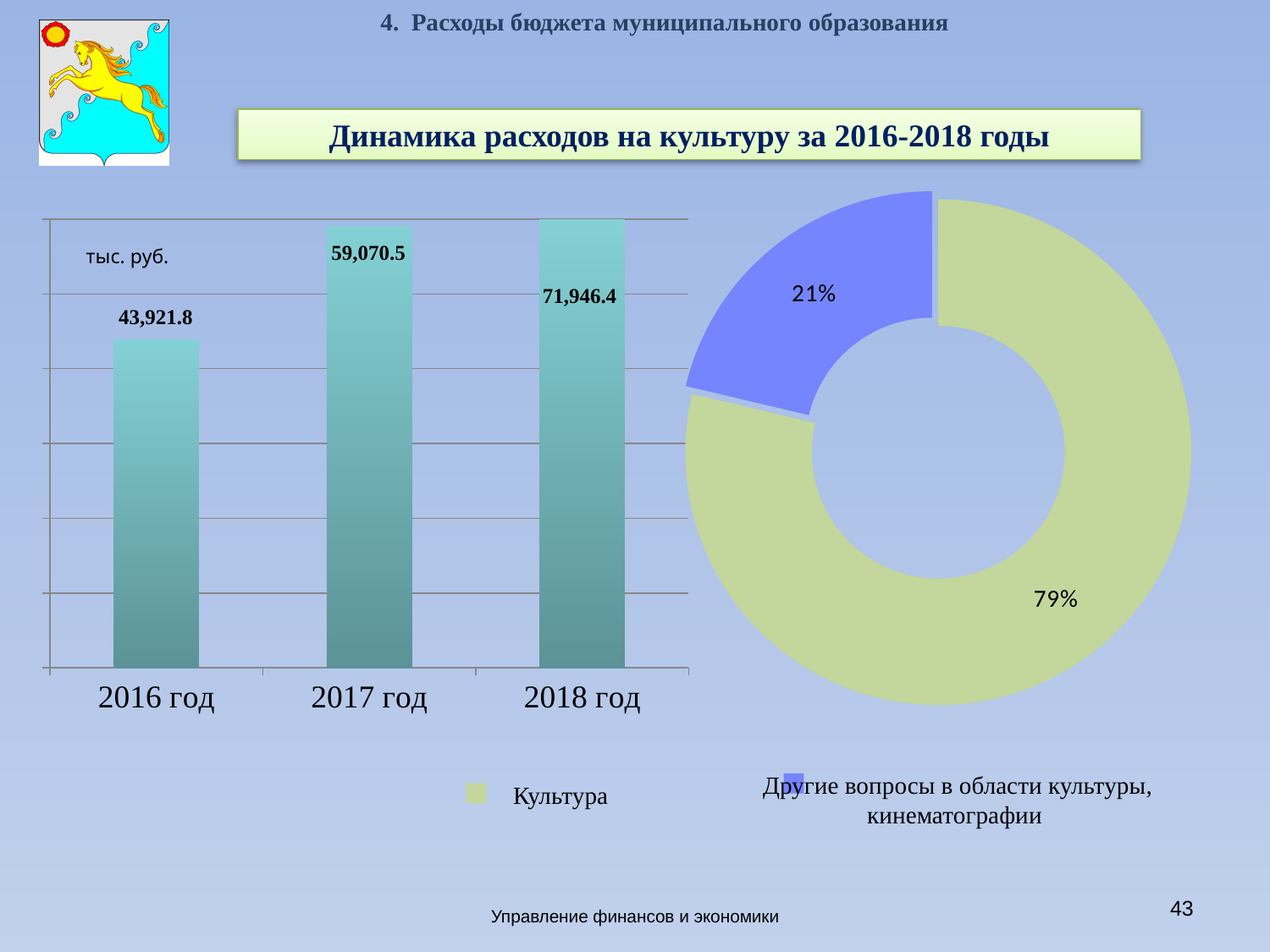
In the pie chart on the right, what share does 'Другие вопросы в области культуры, кинематографии' have? 21% In the bar chart on the left, what unit is indicated for the values? тыс. руб. In the bar chart on the left, how many years are shown? 3 In the bar chart on the left, which year has the highest value? 2018 год What kind of chart is shown on the right side of the slide? doughnut chart In the bar chart on the left, what is the value for 2017 год? 59,070.5 In the bar chart on the left, what is the value for 2016 год? 43,921.8 In the bar chart on the left, do the values rise or fall from 2016 год to 2018 год? rise In the pie chart on the right, what share does Культура have? 79% In the bar chart on the left, which year has the lowest value? 2016 год In the bar chart on the left, what is the value for 2018 год? 71,946.4 In the bar chart on the left, what is the difference between the values for 2018 год and 2016 год? 28,024.6